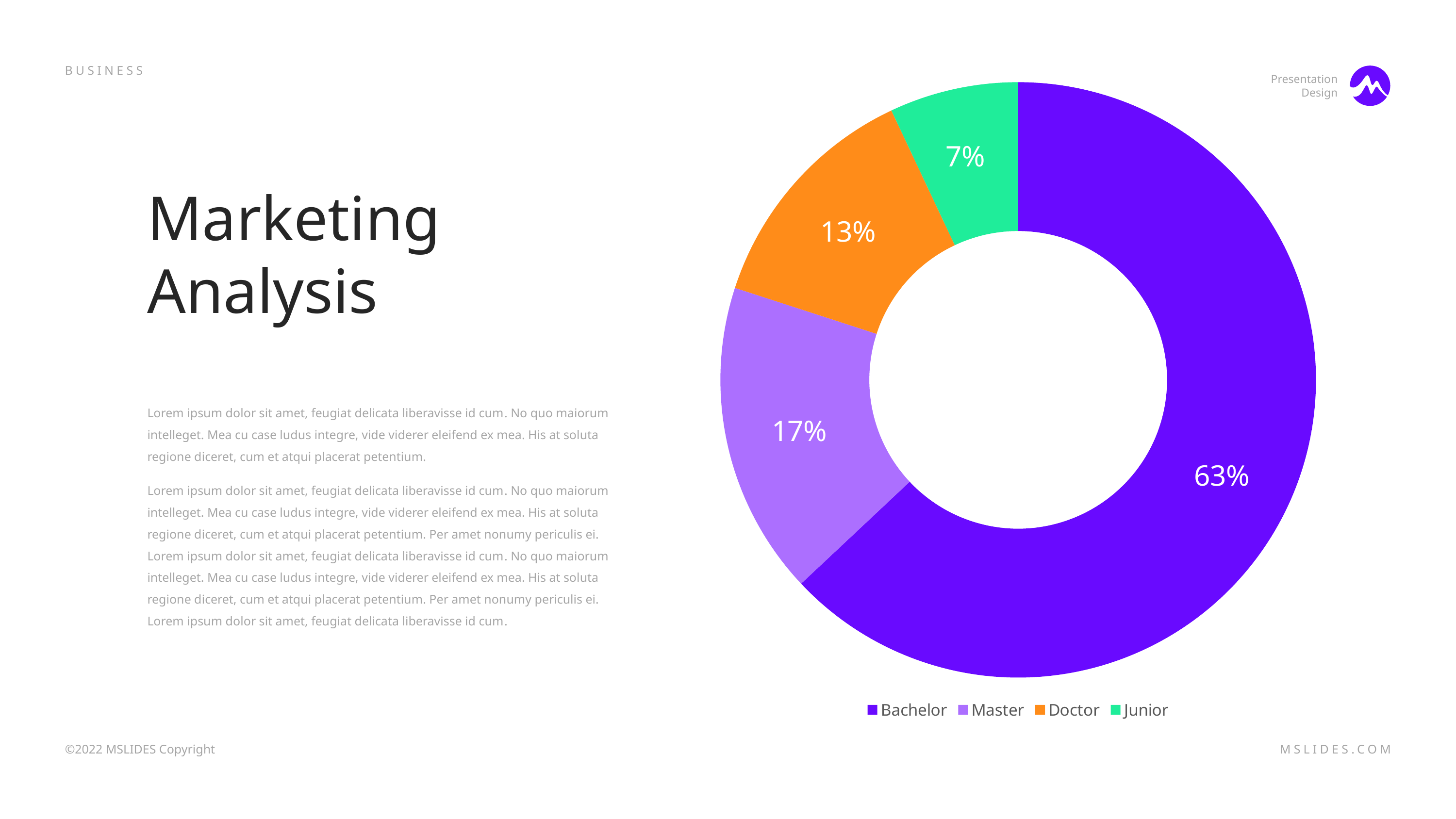
Which category has the smallest slice in the chart? Junior Which colour represents Doctor in the legend? Orange How many categories are shown in the chart? 4 Which category has the largest slice in the chart? Bachelor What share of the doughnut chart does Master represent? 17% What share of the doughnut chart does Junior represent? 7% What is the difference in percentage points between the Bachelor and Master slices? 46 What share of the doughnut chart does Doctor represent? 13% What kind of chart is shown on the slide? Doughnut chart What is the difference in percentage points between the Doctor and Junior slices? 6 Which slice is larger, Master or Doctor? Master